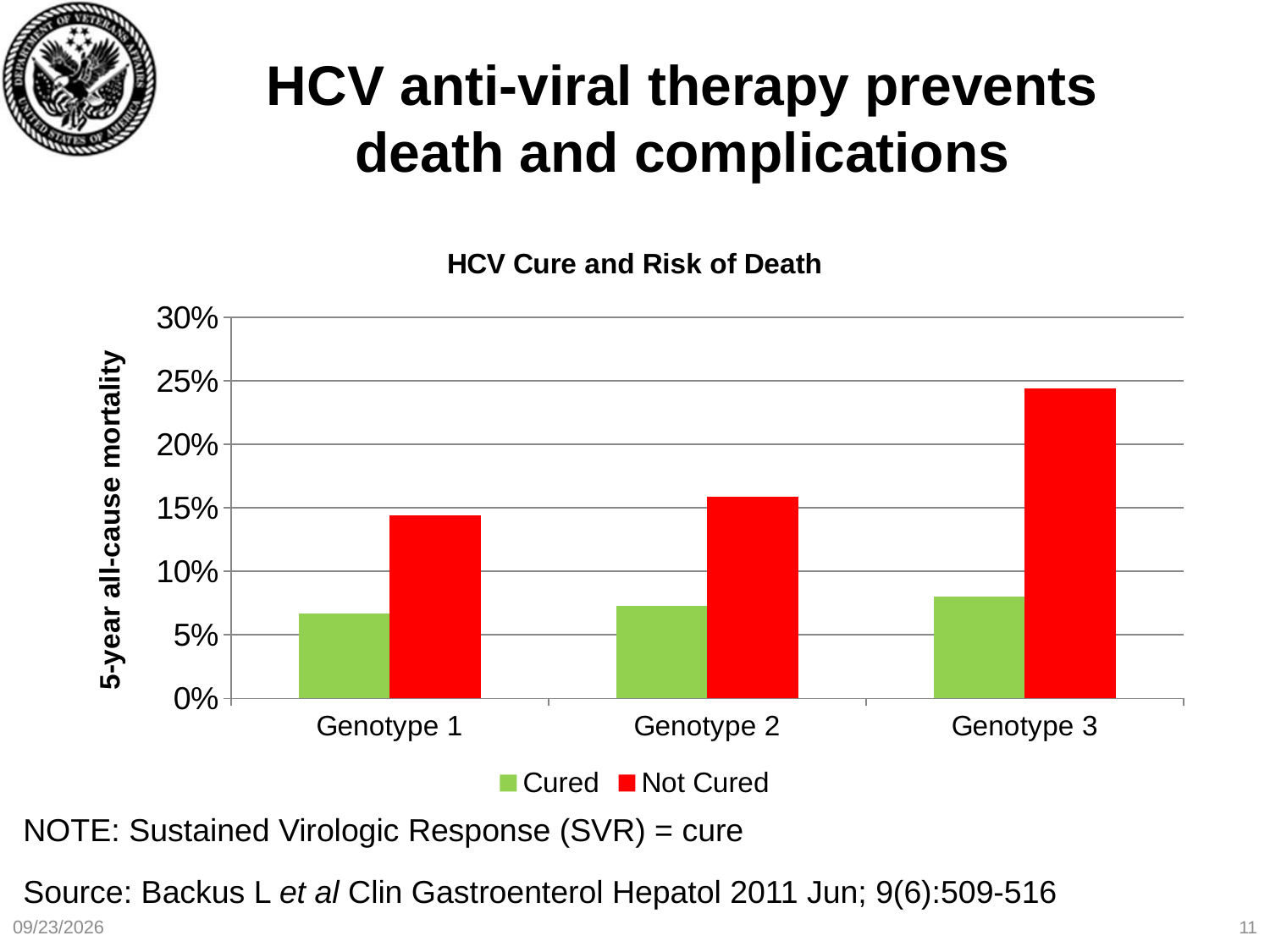
Do the Not Cured values rise or fall from Genotype 1 to Genotype 3? rise Which genotype has the highest Not Cured mortality? Genotype 3 What kind of chart is shown on the slide? bar chart What is the label of the y axis? 5-year all-cause mortality What is the title of the chart? HCV Cure and Risk of Death Which genotype has the lowest Cured mortality? Genotype 1 Is the Not Cured value for Genotype 2 greater or less than 15%? greater Is the Cured value for Genotype 2 greater or less than 10%? less How many series does the legend list? 2 Is the Not Cured value for Genotype 3 greater or less than 20%? greater How many genotype categories are shown on the x axis? 3 For Genotype 1, which is larger: the Cured or the Not Cured mortality? Not Cured